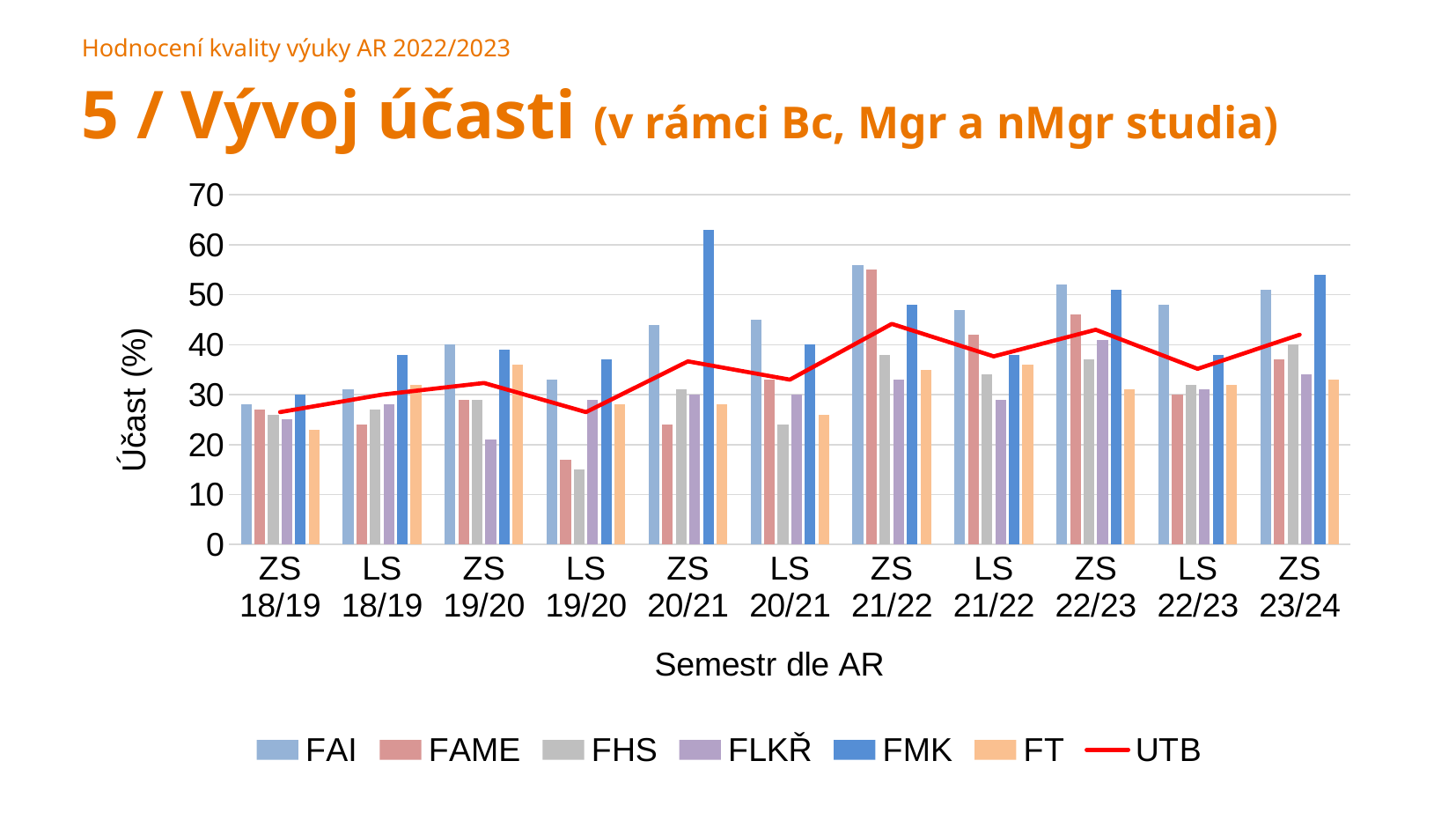
What kind of chart is shown on the slide? bar chart with a line Which faculty has the lowest bar in the whole chart, and in which semester? FHS in LS 19/20 How many series does the chart legend list? 7 Does the UTB line overall rise or fall from ZS 18/19 to ZS 23/24? rise Is the value for FHS in LS 19/20 greater or less than 20? less Is the value for FAI in ZS 21/22 greater or less than 50? greater Is the value for FMK in ZS 20/21 greater or less than 60? greater What is the title of the y axis of the chart? Účast (%) In ZS 21/22, which is larger: the value for FAI or the value for FT? FAI Which faculty has the highest bar in the whole chart, and in which semester? FMK in ZS 20/21 How many semesters (categories) are shown on the x axis of the chart? 11